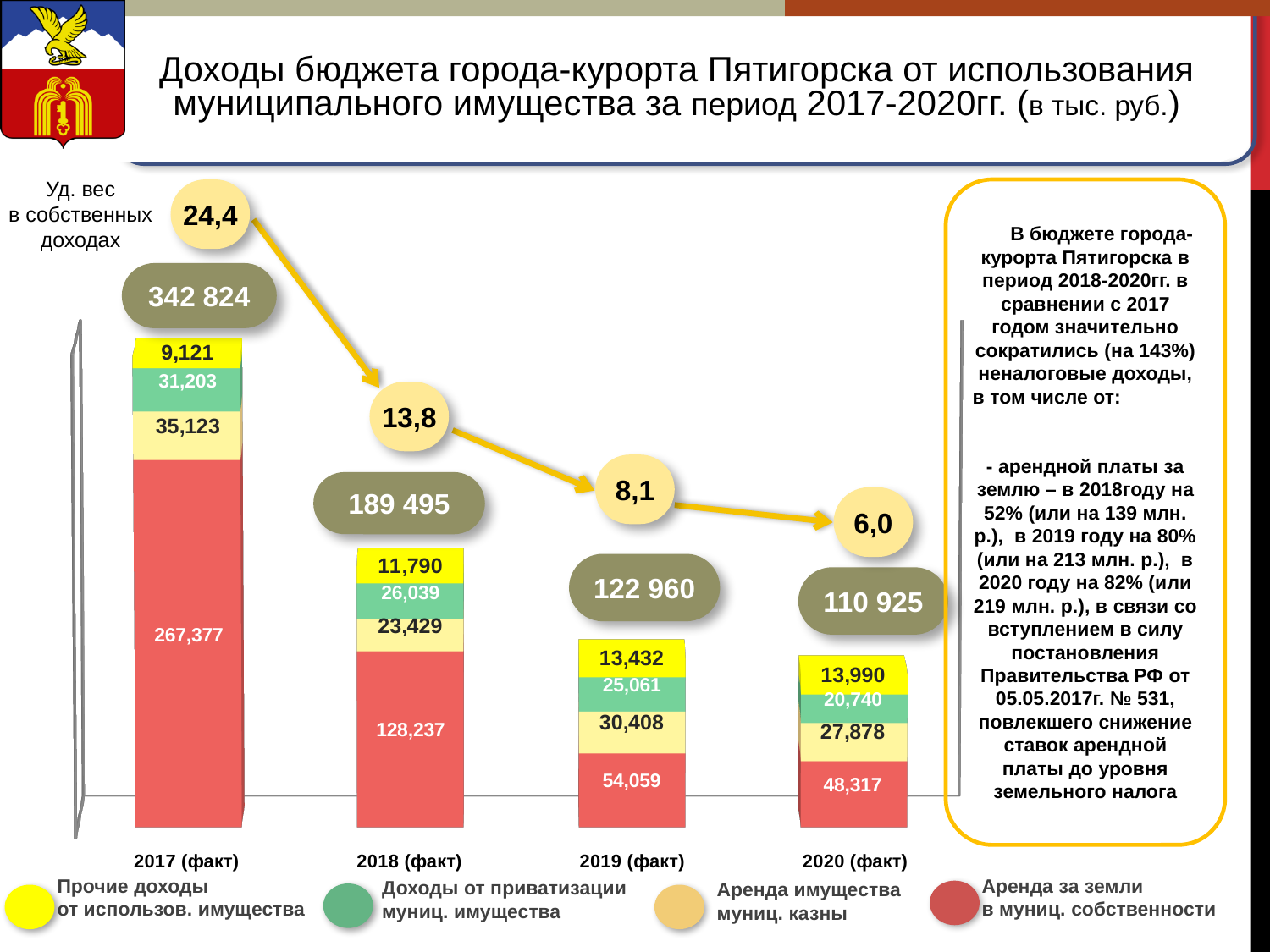
What type of chart is shown on the slide? stacked bar chart Which year has the lowest total shown above its bar? 2020 (факт) What is the total shown for the 2018 (факт) bar? 189 495 What is the difference between the 'Аренда за земли в муниц. собственности' values for 2019 (факт) and 2020 (факт)? 5,742 What is the value of 'Аренда за земли в муниц. собственности' for 2017 (факт)? 267,377 What is the value of 'Доходы от приватизации муниц. имущества' for 2018 (факт)? 26,039 How many series does the legend list? 4 What is the value of 'Прочие доходы от использов. имущества' for 2020 (факт)? 13,990 What is the value of 'Аренда имущества муниц. казны' for 2019 (факт)? 30,408 Which year has the highest value for 'Аренда за земли в муниц. собственности'? 2017 (факт) Do the bar totals rise or fall from 2017 to 2020? fall How many year categories are shown on the x axis of the chart? 4